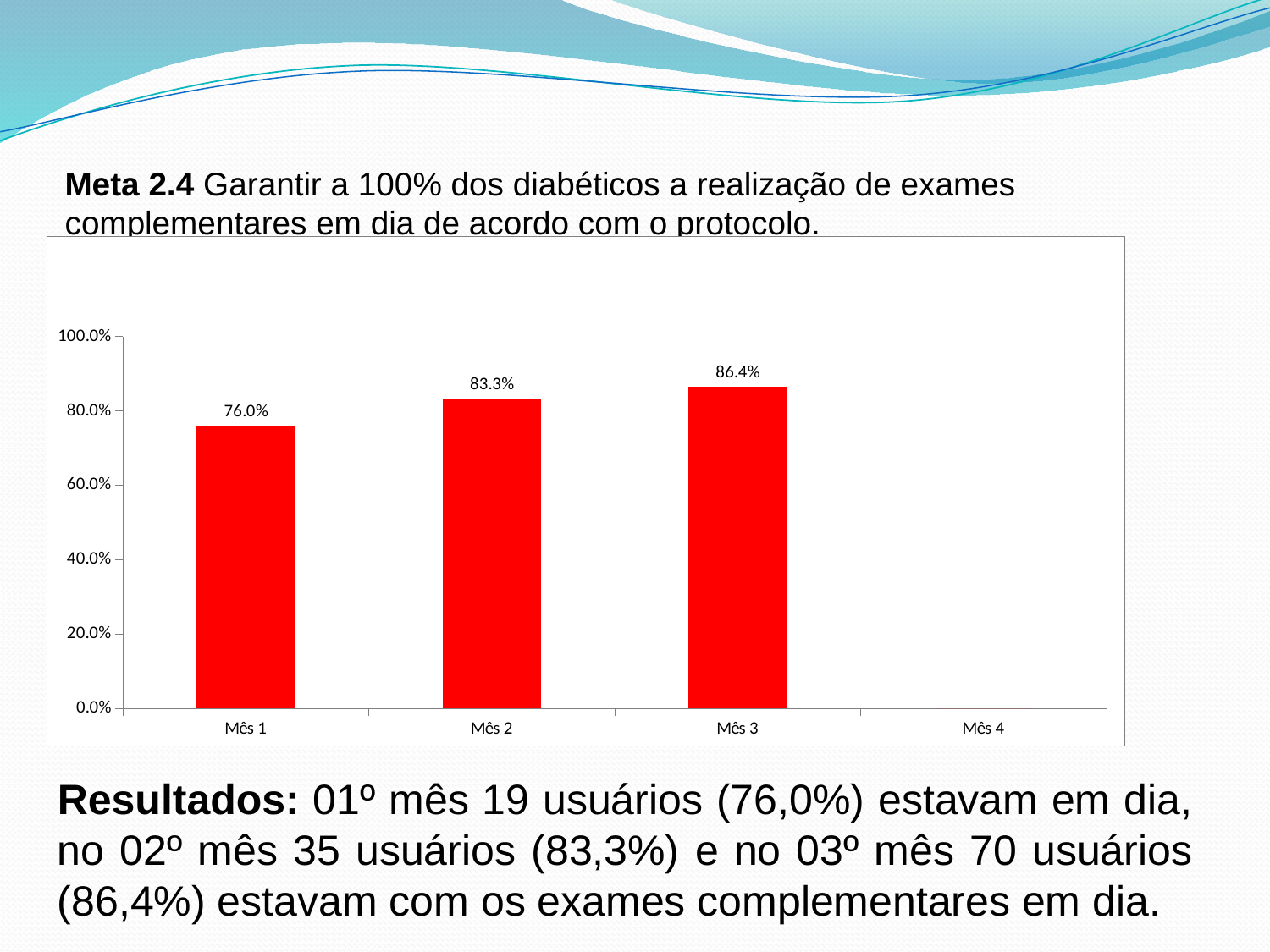
What is the value for Mês 3? 86.4% How many bars are plotted in the chart? 3 What is the difference between the values for Mês 2 and Mês 1? 7.3 percentage points Which of the plotted months has the lowest value? Mês 1 What is the value for Mês 1? 76.0% Do the values rise or fall from Mês 1 to Mês 3? Rise Which month has the highest value? Mês 3 What is the value for Mês 2? 83.3% Is the value for Mês 1 greater or less than 80.0%? less What is the difference between the values for Mês 3 and Mês 1? 10.4 percentage points Which is larger, the value for Mês 2 or the value for Mês 3? Mês 3 What kind of chart is shown on the slide? Bar chart